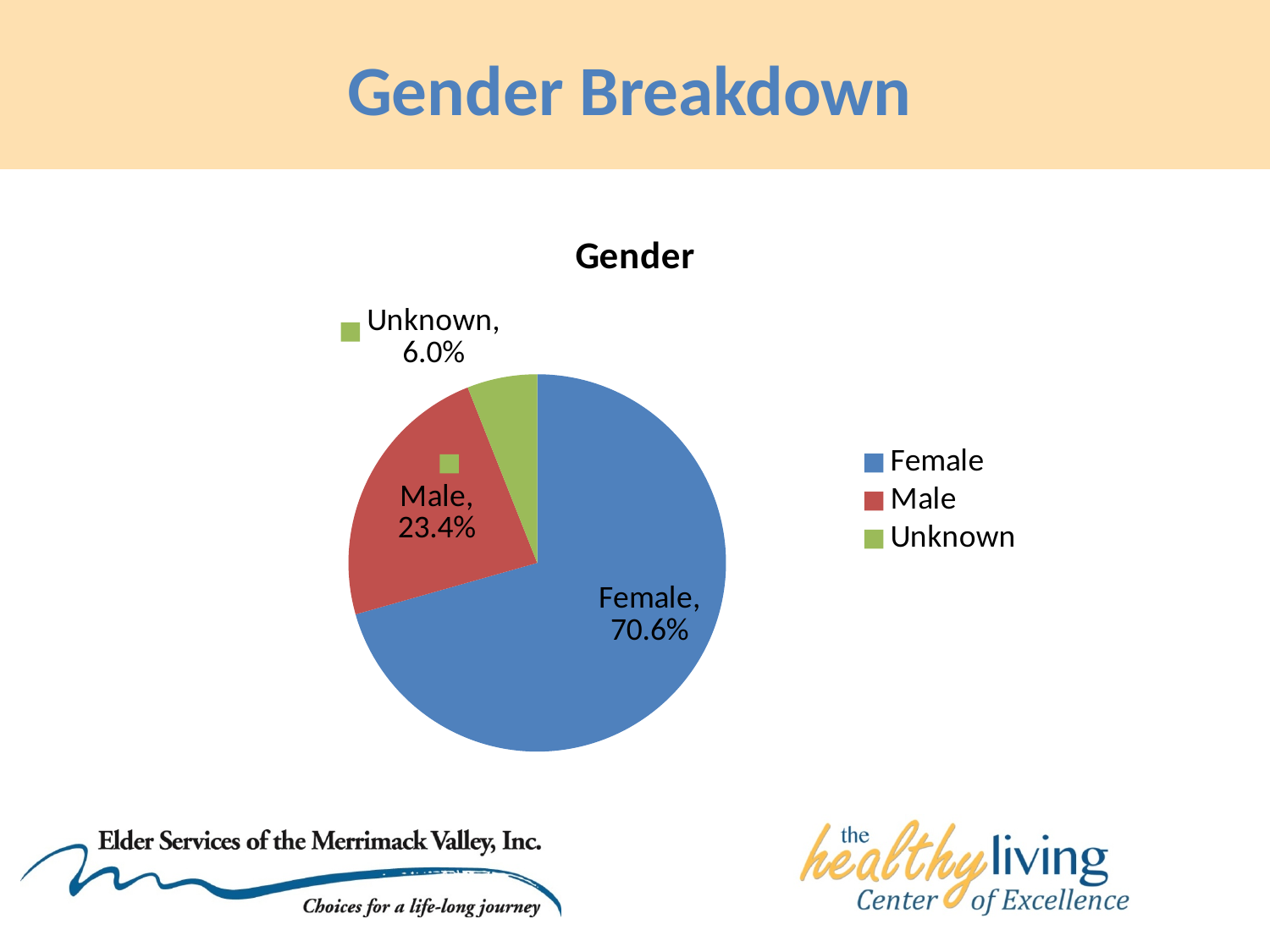
What is the title of the chart? Gender What is the difference in percentage points between the Female and Male shares? 47.2 Which category has the smallest share of the pie chart? Unknown Which share is larger, Male or Unknown? Male What is the difference in percentage points between the Male and Unknown shares? 17.4 What colour is the Male slice in the pie chart? Red What percentage of the pie chart is Male? 23.4% What percentage of the pie chart is Unknown? 6.0% Which category has the largest share of the pie chart? Female What percentage of the pie chart is Female? 70.6% How many categories are shown in the pie chart? 3 What kind of chart is shown on the slide? Pie chart